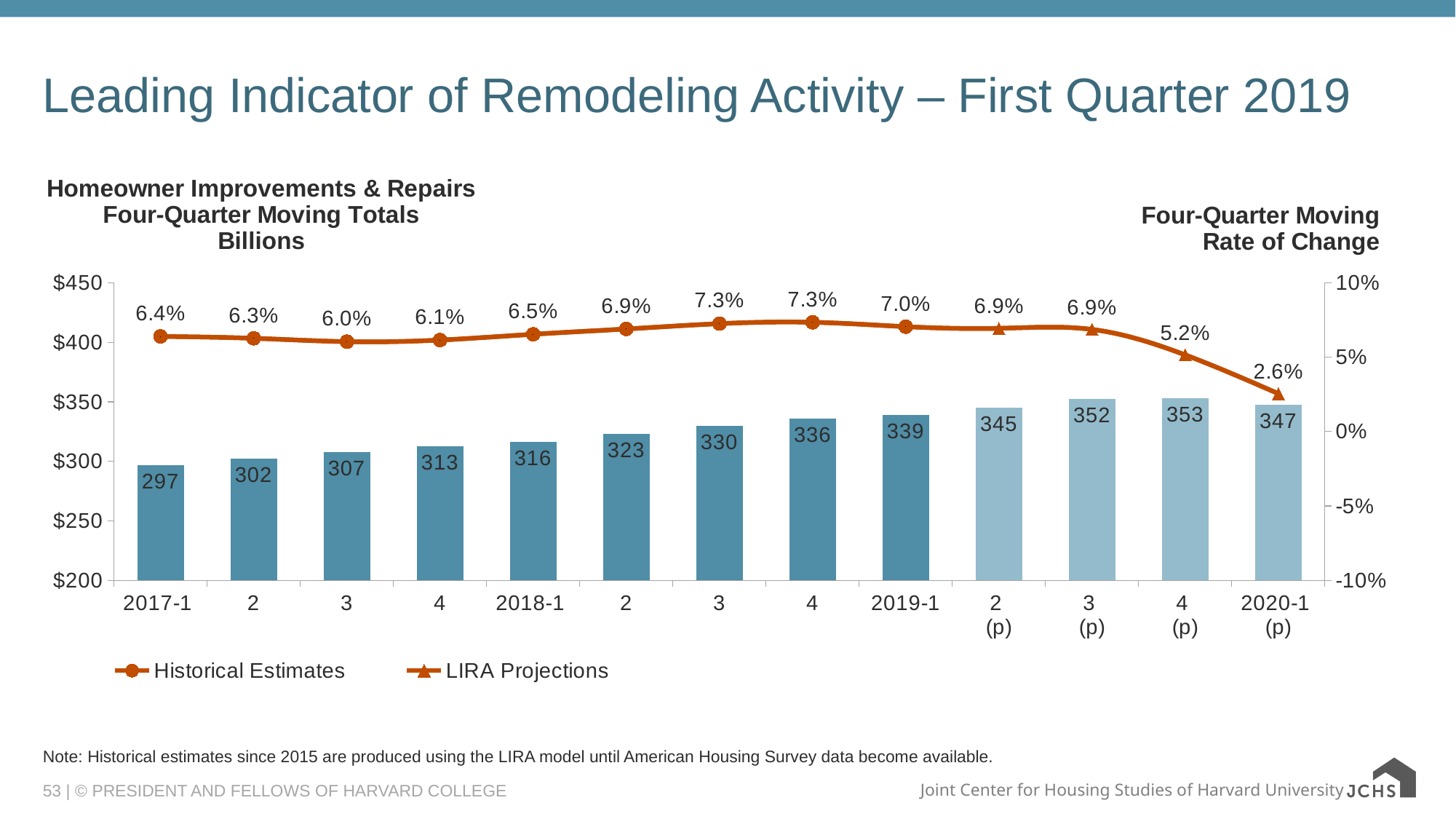
What kind of chart is used for the four-quarter moving totals? bar chart What are the two legend entries for the line series? Historical Estimates and LIRA Projections Which is larger, the rate of change for 2018-3 or for 2018-1? 2018-3 Which quarter has the highest four-quarter moving total? 4 (p) (2019) How many series does the legend list? 2 Do the four-quarter moving totals rise or fall from 2017-1 to 2019-4 (p)? rise What is the difference between the four-quarter moving totals for 2019-1 and 2017-1? 42 What is the projected four-quarter moving total for 2020-1 (p)? 347 How many quarters are shown on the x axis? 13 Which quarter has the lowest four-quarter moving rate of change? 2020-1 (p) What is the four-quarter moving total (in billions) for 2017-1? 297 What is the four-quarter moving rate of change for 2019-1? 7.0%